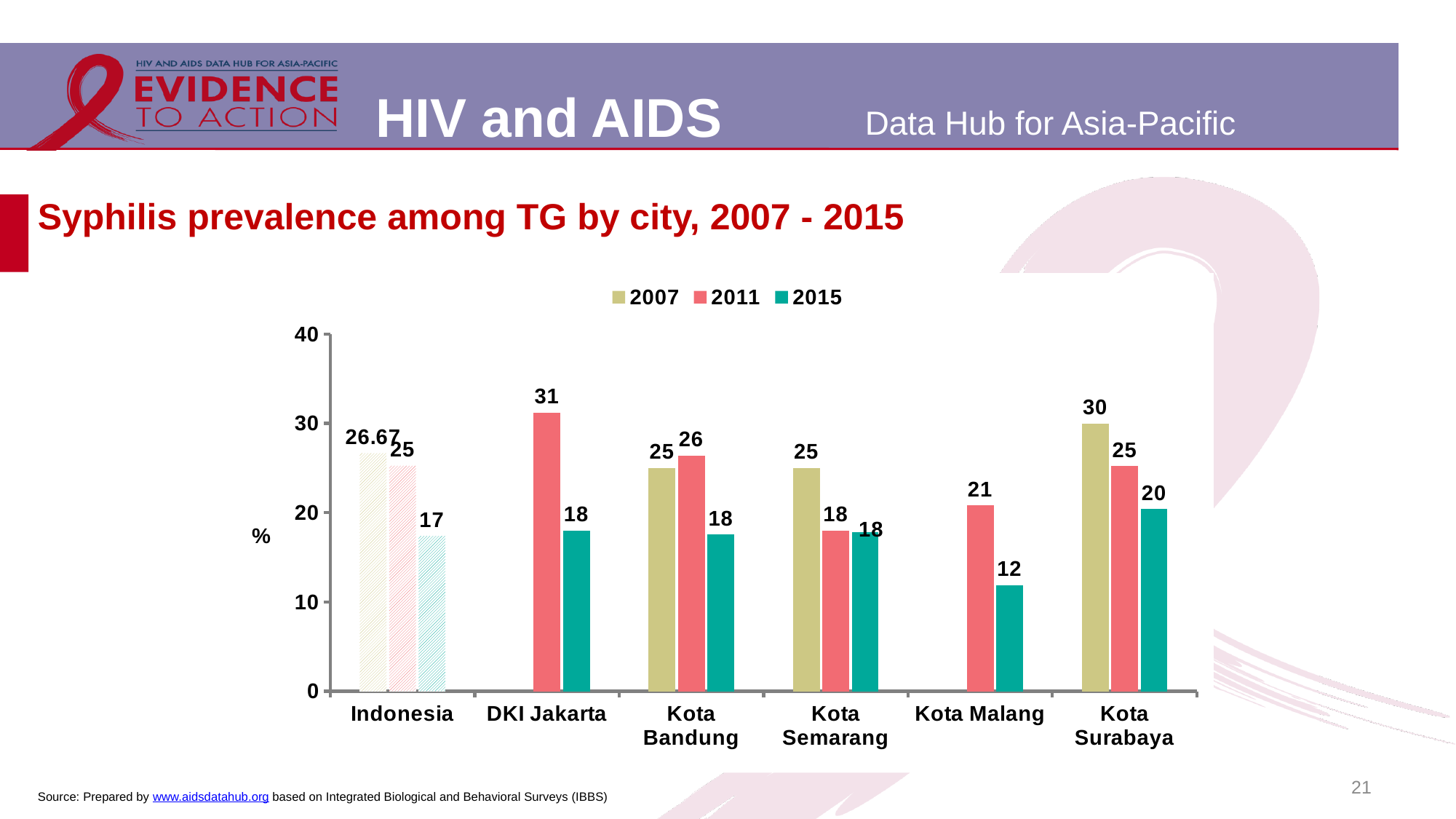
Which city has the lowest 2015 value? Kota Malang Do the values for Kota Surabaya rise or fall from 2007 to 2015? Fall What is the 2015 value for Kota Malang? 12 Which is larger for Kota Surabaya, the 2007 value or the 2015 value? 2007 What is the 2007 value for Kota Surabaya? 30 What is the difference between the 2011 and 2015 values for Kota Malang? 9 How many series does the legend list? 3 Which city has the highest 2011 value? DKI Jakarta What kind of chart is shown on the slide? Bar chart What is the 2011 value for DKI Jakarta? 31 How many cities or categories are shown on the x axis? 6 What is the 2007 value for Indonesia? 26.67